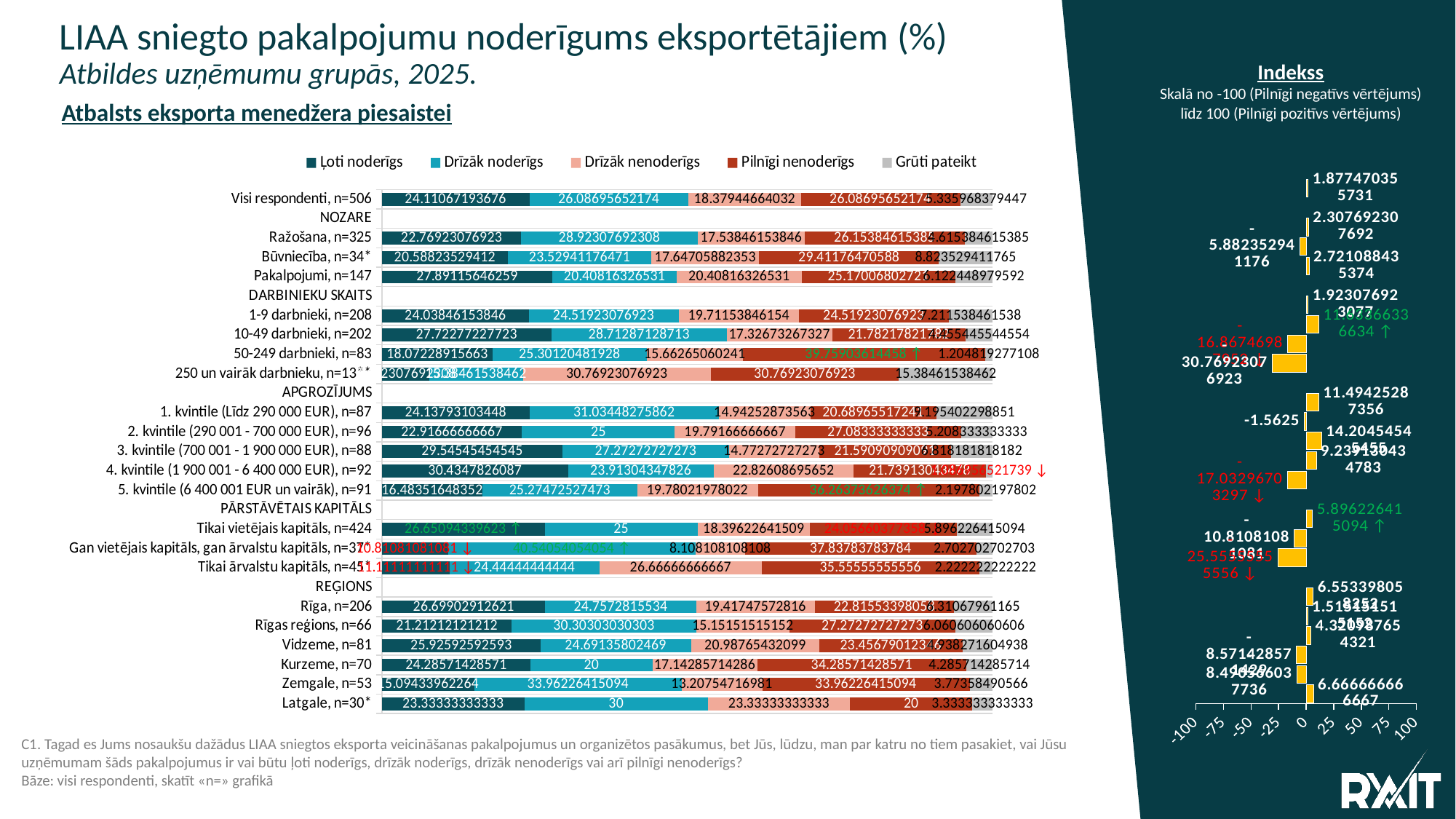
What is the range of the scale of the 'Indekss' chart on the right? -100 to 100 In the main chart, what is the difference between the 'Drīzāk noderīgs' and 'Pilnīgi nenoderīgs' values for Latgale, n=30*? 10 How many regions are listed under the REĢIONS section of the main chart? 6 What kind of chart is the main chart on the left of the slide? Stacked bar chart How many series does the legend of the main chart list? 5 In the main chart, what is the 'Drīzāk noderīgs' value for 2. kvintile (290 001 - 700 000 EUR), n=96? 25 In the main chart, what is the 'Pilnīgi nenoderīgs' value for Latgale, n=30*? 20 In the main chart, what is the 'Drīzāk noderīgs' value for Latgale, n=30*? 30 In the main chart, what is the 'Drīzāk noderīgs' value for Tikai vietējais kapitāls, n=424? 25 In the main chart, which group has the highest 'Drīzāk noderīgs' value? Gan vietējais kapitāls, gan ārvalstu kapitāls, n=37* In the main chart, for Latgale, n=30*, which is larger: 'Drīzāk noderīgs' or 'Pilnīgi nenoderīgs'? Drīzāk noderīgs In the main chart, what is the 'Drīzāk noderīgs' value for Kurzeme, n=70? 20